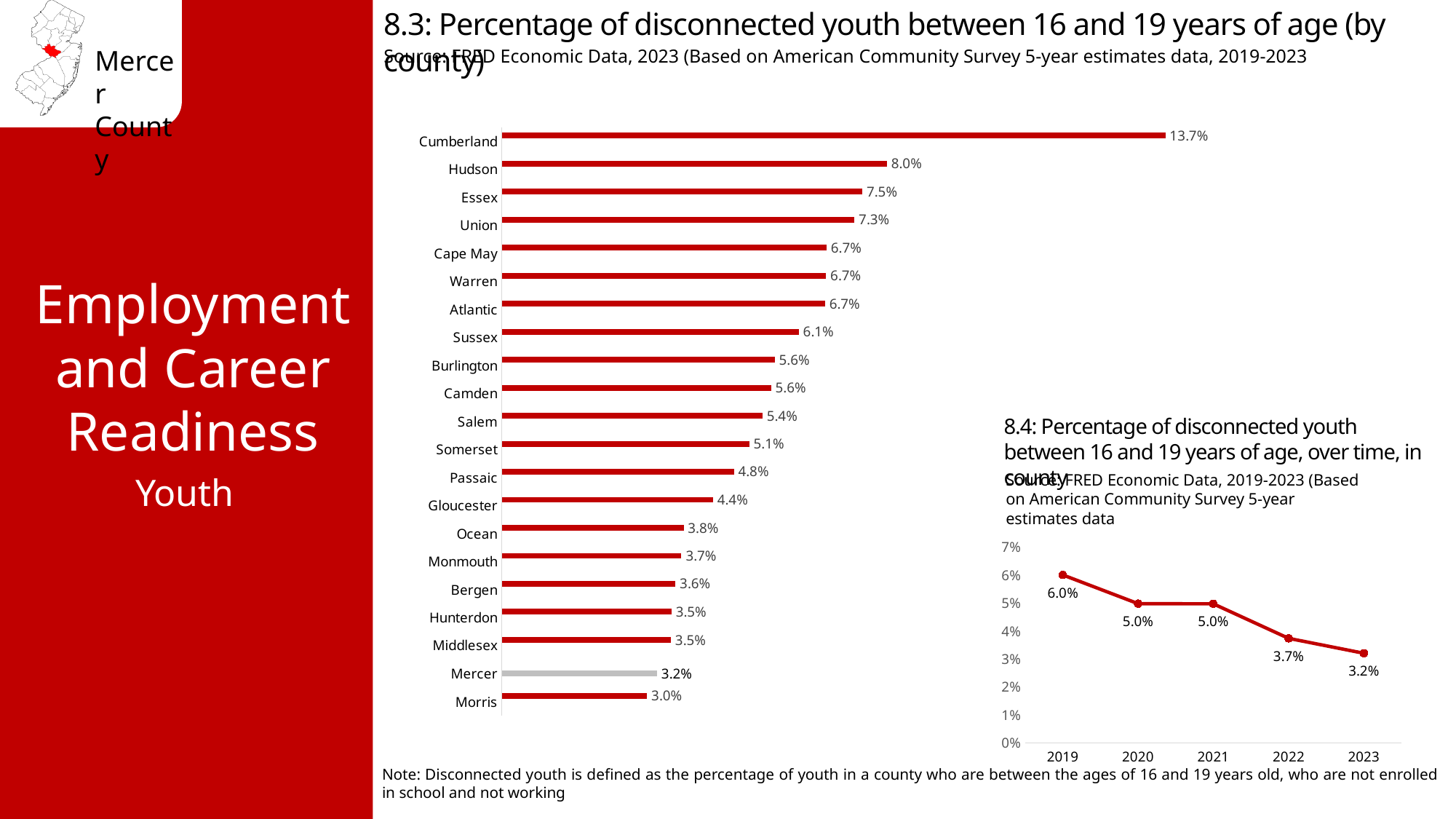
In the 8.3 bar chart, which county has the lowest percentage of disconnected youth? Morris In the 8.3 bar chart, what is the difference between Hudson and Mercer? 4.8% In the 8.3 bar chart, what is the value for Mercer? 3.2% In the 8.3 bar chart, which county has the highest percentage of disconnected youth? Cumberland In the 8.4 line chart, do the values rise or fall from 2019 to 2023? Fall What kind of chart is chart 8.3? Bar chart In the 8.3 bar chart, which is larger, the value for Essex or the value for Union? Essex How many counties are shown in the 8.3 bar chart? 21 In the 8.4 line chart, what is the difference between the 2019 and 2023 values? 2.8% In the 8.3 bar chart, what is the percentage of disconnected youth for Cumberland? 13.7% In the 8.4 line chart, what is the value for 2019? 6.0% In the 8.3 bar chart, which county's bar is shown in grey rather than red? Mercer